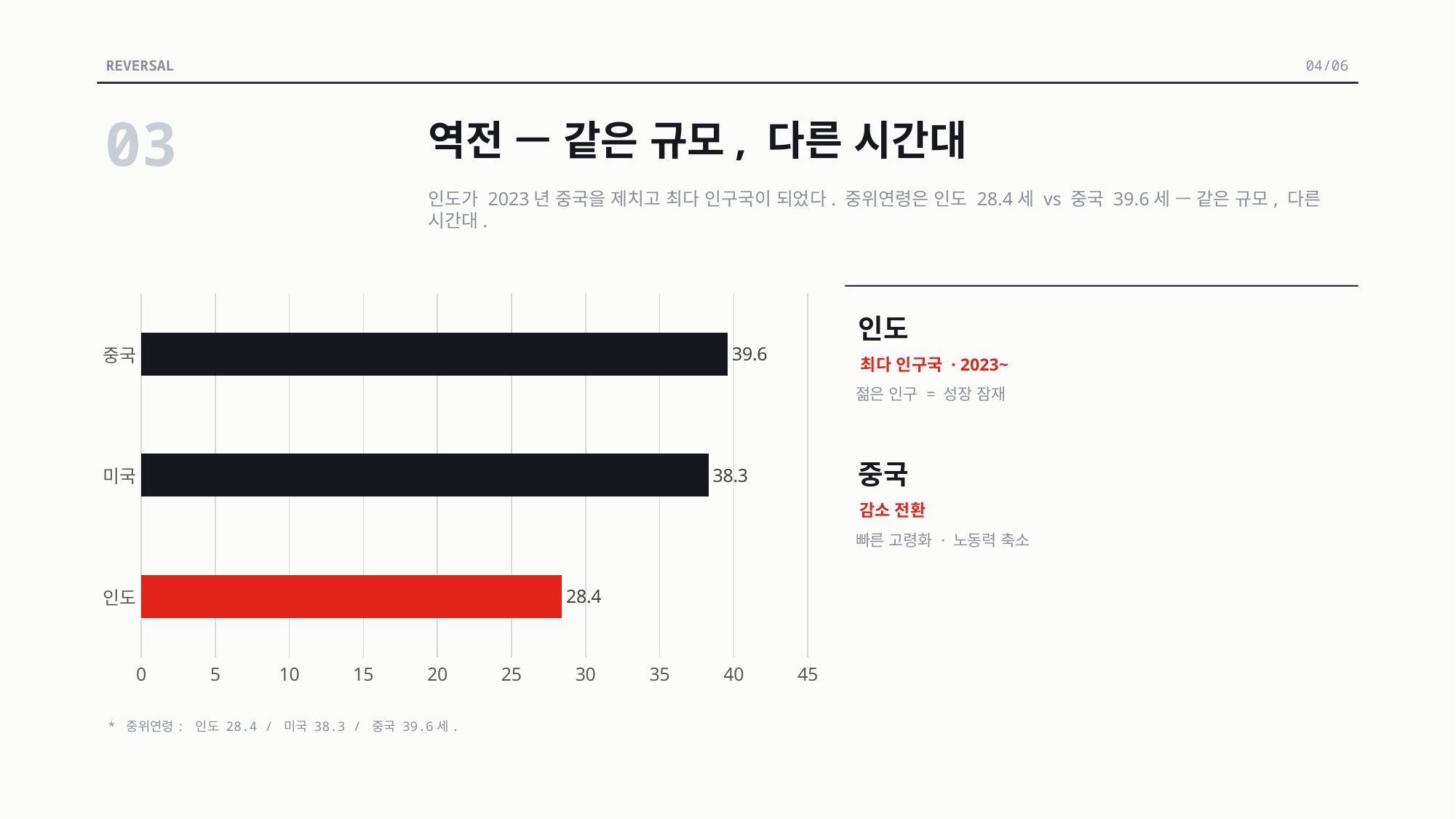
What is the value for 중국 in the chart? 39.6 What is the value for 미국 in the chart? 38.3 Which category has the highest value in the chart? 중국 Which category's bar is coloured red in the chart? 인도 What is the difference between the values for 중국 and 인도? 11.2 Is the value for 인도 greater or less than 30? less What kind of chart is shown on the slide? bar chart Which category has the lowest value in the chart? 인도 Which is larger, the value for 미국 or the value for 인도? 미국 What is the difference between the values for 미국 and 인도? 9.9 How many categories are shown in the chart? 3 What is the value for 인도 in the chart? 28.4